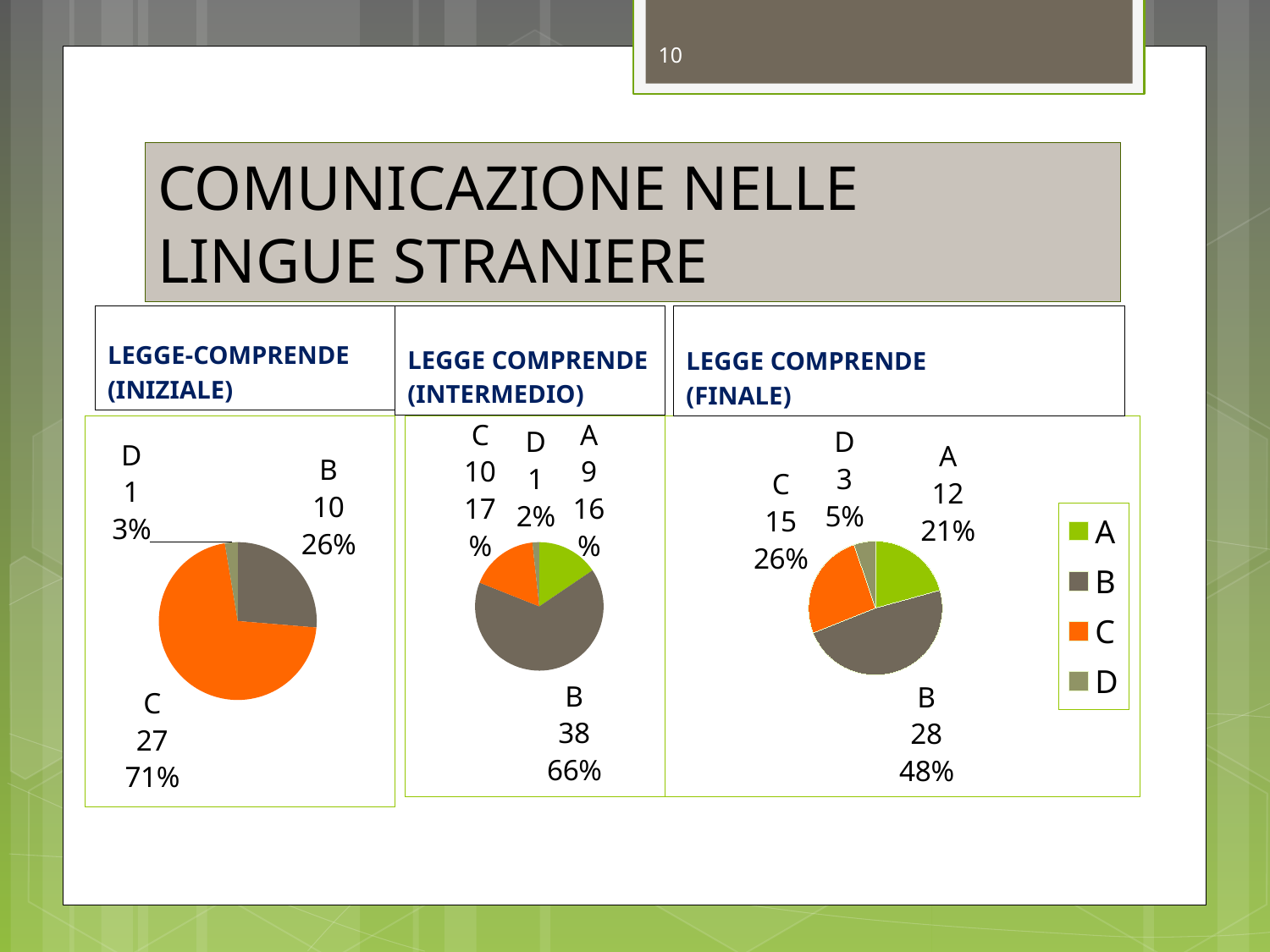
In the LEGGE COMPRENDE (INTERMEDIO) chart, which category has the largest slice? B In the LEGGE COMPRENDE (INTERMEDIO) chart, what share of the pie does C represent? 17% In the LEGGE COMPRENDE (INTERMEDIO) chart, what is the value for B? 38 In the LEGGE-COMPRENDE (INIZIALE) chart, what share of the pie does B represent? 26% In the LEGGE-COMPRENDE (INIZIALE) chart, what is the value for C? 27 In the LEGGE COMPRENDE (FINALE) chart, which is larger, the value for A or the value for C? C What kind of chart is the LEGGE-COMPRENDE (INIZIALE) chart? Pie chart In the LEGGE COMPRENDE (INTERMEDIO) chart, how many categories are shown? 4 In the LEGGE COMPRENDE (FINALE) chart, what share of the pie does D represent? 5% In the LEGGE-COMPRENDE (INIZIALE) chart, which category has the smallest slice? D In the LEGGE COMPRENDE (FINALE) chart, what is the difference between the values for B and C? 13 In the LEGGE COMPRENDE (FINALE) chart, what is the value for A? 12